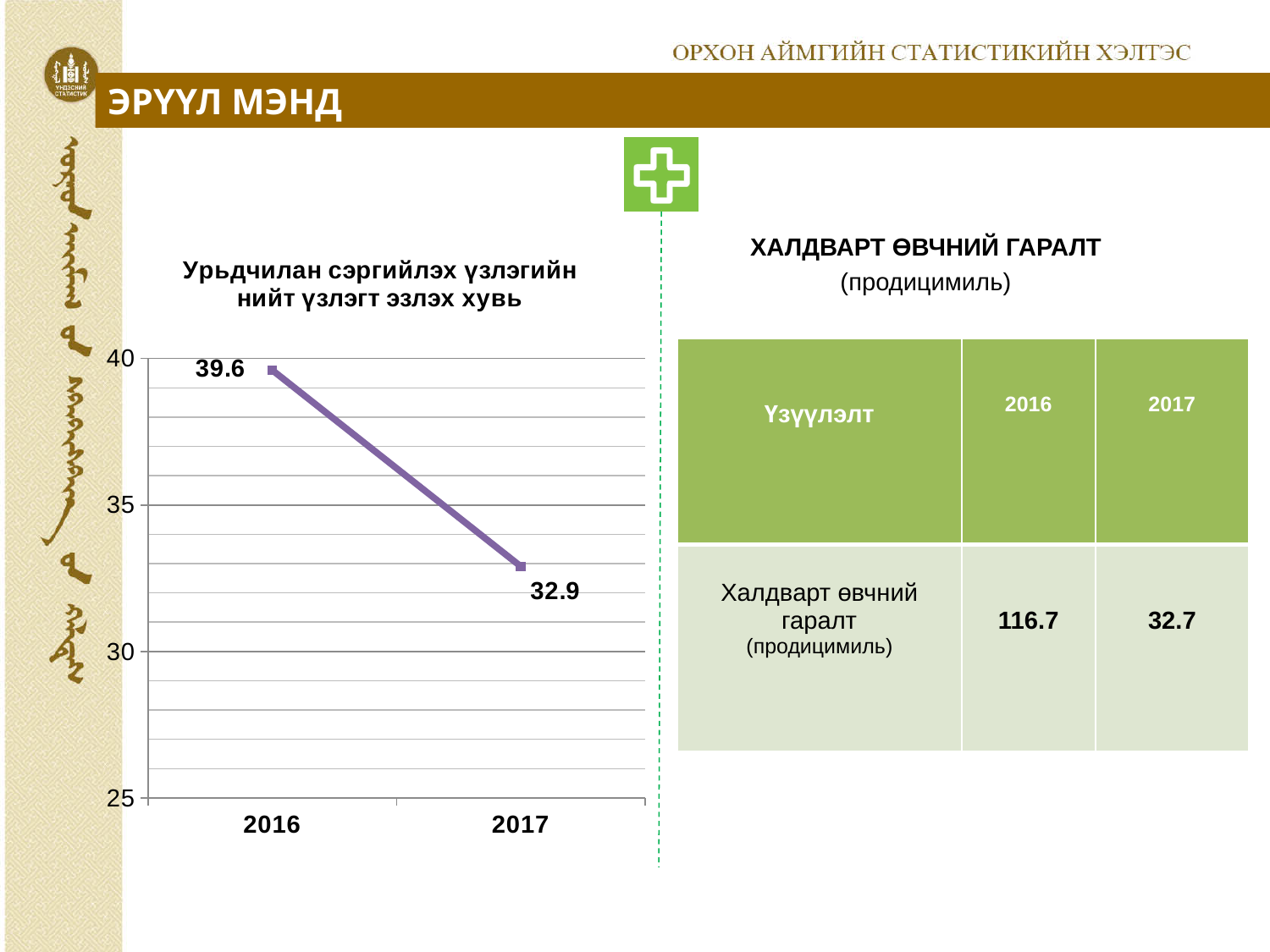
Which year has the higher value in the chart? 2016 What is the value for 2016 in the chart? 39.6 Is the value for 2017 larger or smaller than the value for 2016? smaller Which year has the lower value in the chart? 2017 What type of chart is shown on the slide? line chart What is the value for 2017 in the chart? 32.9 Is the value for 2016 greater or less than 35? greater Is the value for 2017 greater or less than 35? less What is the title of the chart? Урьдчилан сэргийлэх үзлэгийн нийт үзлэгт эзлэх хувь What is the difference between the 2016 and 2017 values in the chart? 6.7 How many data points are plotted in the chart? 2 Does the value rise or fall from 2016 to 2017? fall